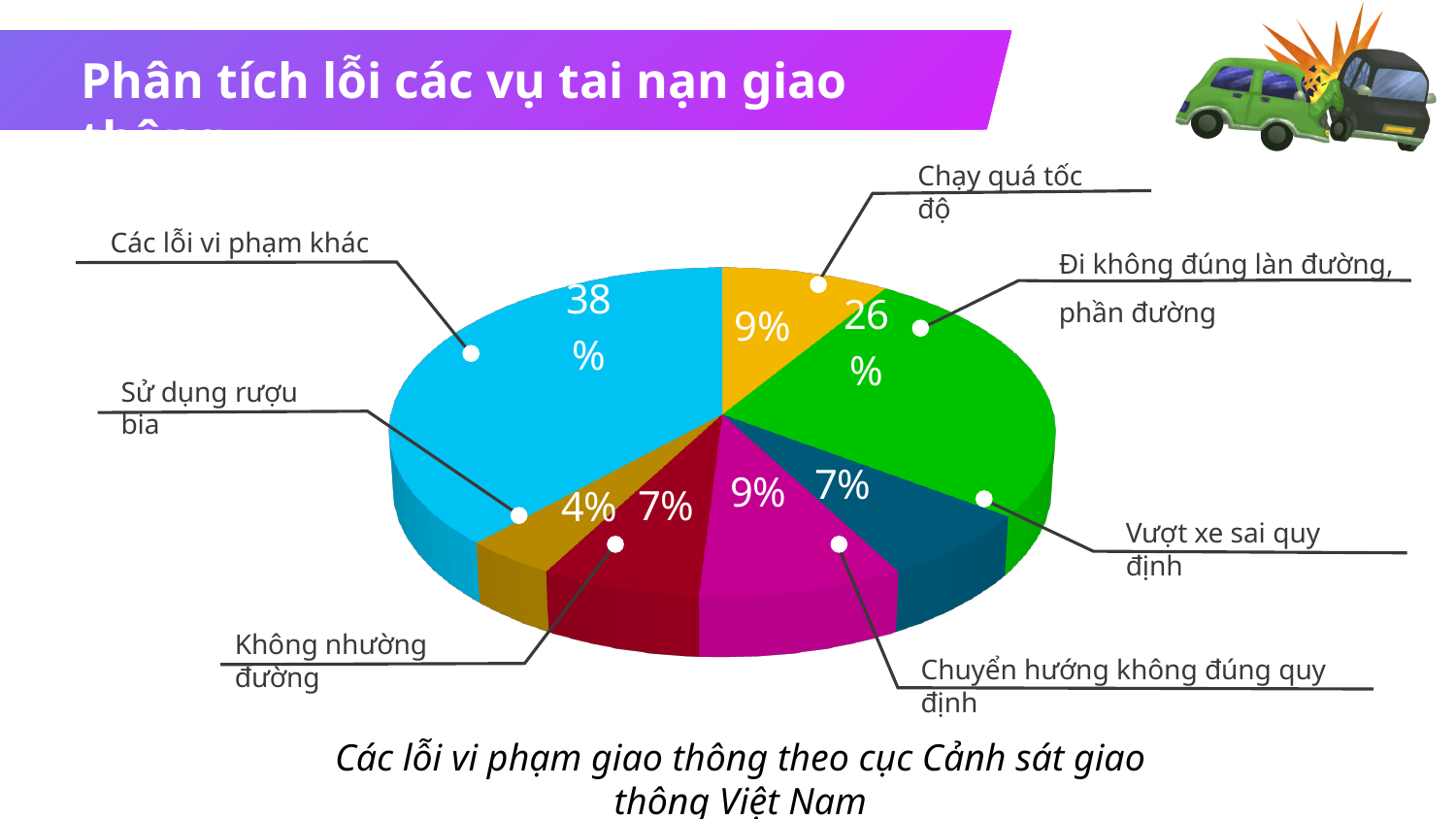
Which is larger: "Chuyển hướng không đúng quy định" or "Không nhường đường"? Chuyển hướng không đúng quy định What is the value shown for "Sử dụng rượu bia"? 4% What is the caption written below the chart? Các lỗi vi phạm giao thông theo cục Cảnh sát giao thông Việt Nam What share does "Đi không đúng làn đường, phần đường" have in the pie chart? 26% Which category has the smallest slice of the pie chart? Sử dụng rượu bia What type of chart is shown on the slide? Pie chart How many slices does the pie chart have? 7 Which category has the largest slice of the pie chart? Các lỗi vi phạm khác What is the difference in percentage points between "Các lỗi vi phạm khác" and "Đi không đúng làn đường, phần đường"? 12 What percentage of the pie chart is labelled "Các lỗi vi phạm khác"? 38% What percentage is shown for "Chạy quá tốc độ"? 9% What is the value for "Vượt xe sai quy định"? 7%